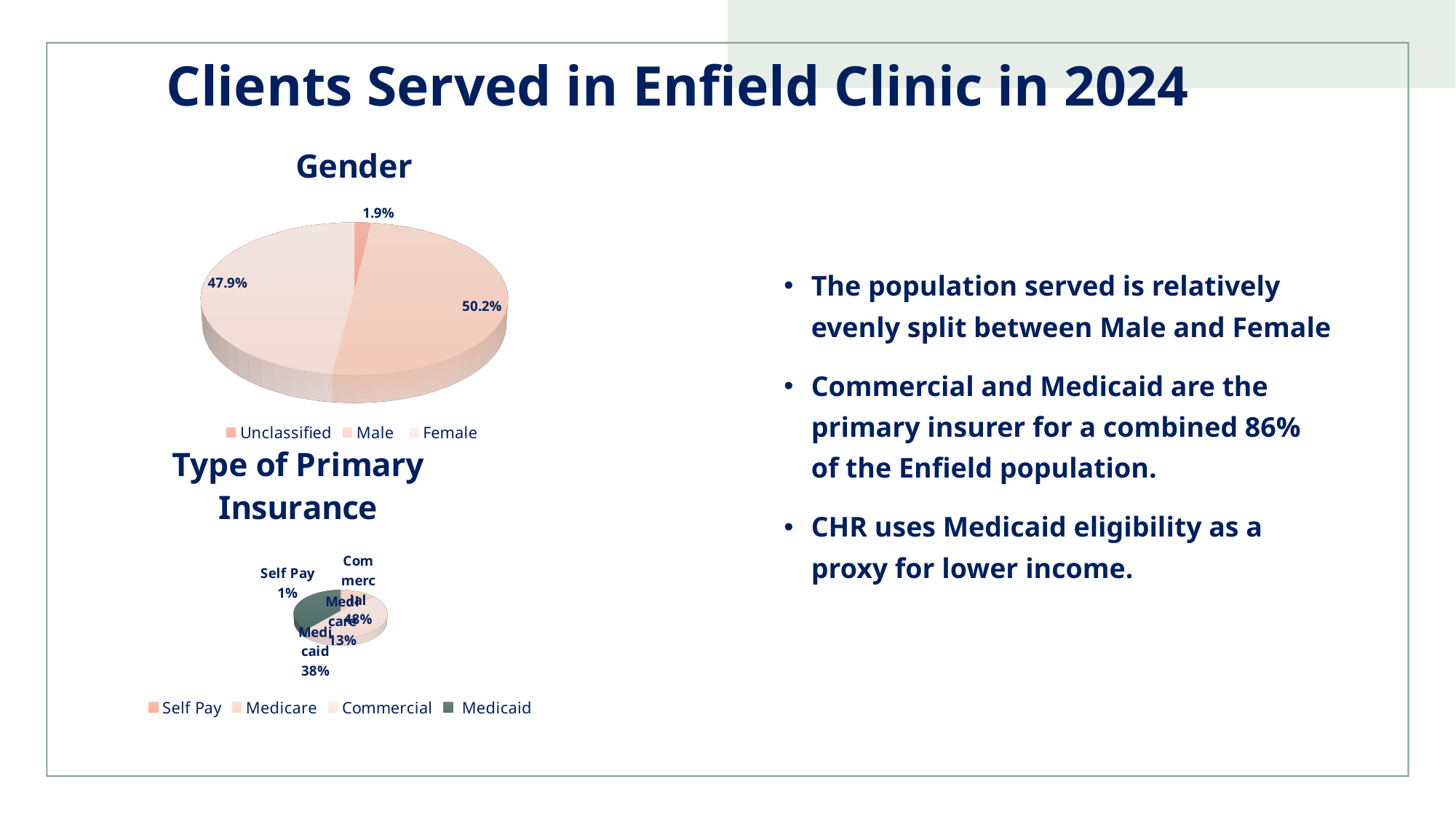
In the Gender chart, which category has the smallest share? Unclassified In the Type of Primary Insurance chart, what share of clients has Commercial insurance? 48% In the Type of Primary Insurance chart, what share of clients has Medicaid? 38% In the Gender chart, what is the difference in percentage points between the Male and Female shares? 2.3 In the Gender chart, what share of clients is Male? 50.2% In the Type of Primary Insurance chart, which is larger, Medicaid or Medicare? Medicaid In the Gender chart, what share of clients is Female? 47.9% In the Type of Primary Insurance chart, which category has the largest share? Commercial How many categories does the legend of the Gender chart list? 3 In the Gender chart, what share of clients is Unclassified? 1.9% What kind of chart is the Type of Primary Insurance chart? Pie chart In the Type of Primary Insurance chart, what share of clients has Medicare? 13%